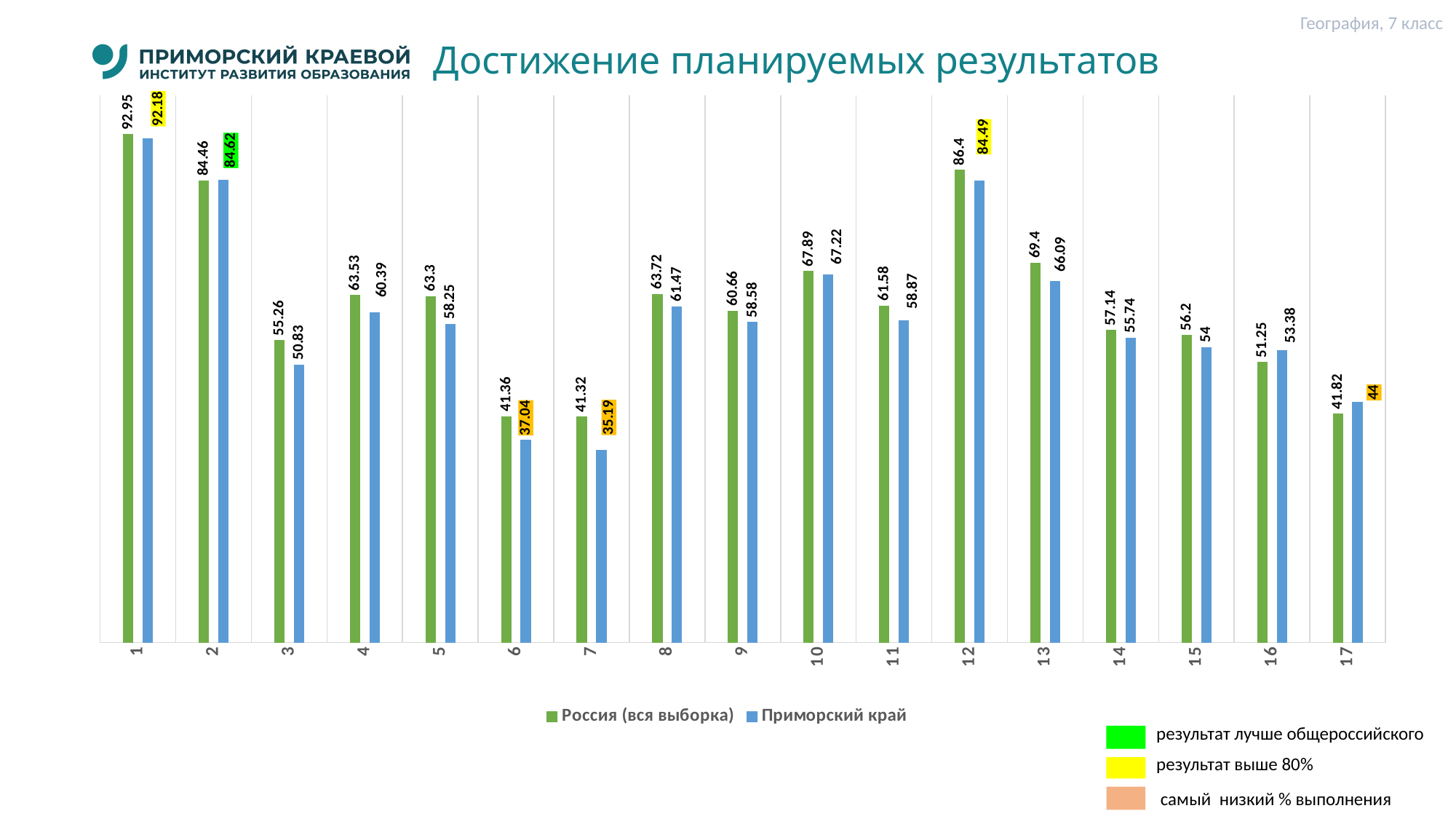
What is the difference between Россия (вся выборка) and Приморский край at category 3? 4.43 Which category has the highest value for Приморский край? 1 What kind of chart is shown on the slide? bar chart Which category has the lowest value for Приморский край? 7 What is the value for Россия (вся выборка) at category 15? 56.2 What is the value for Приморский край at category 1? 92.18 How many series does the legend list? 2 What is the difference between Приморский край and Россия (вся выборка) at category 17? 2.18 What is the value for Приморский край at category 7? 35.19 How many categories are shown on the x axis? 17 What is the value for Россия (вся выборка) at category 12? 86.4 At category 16, which series has the larger value: Россия (вся выборка) or Приморский край? Приморский край